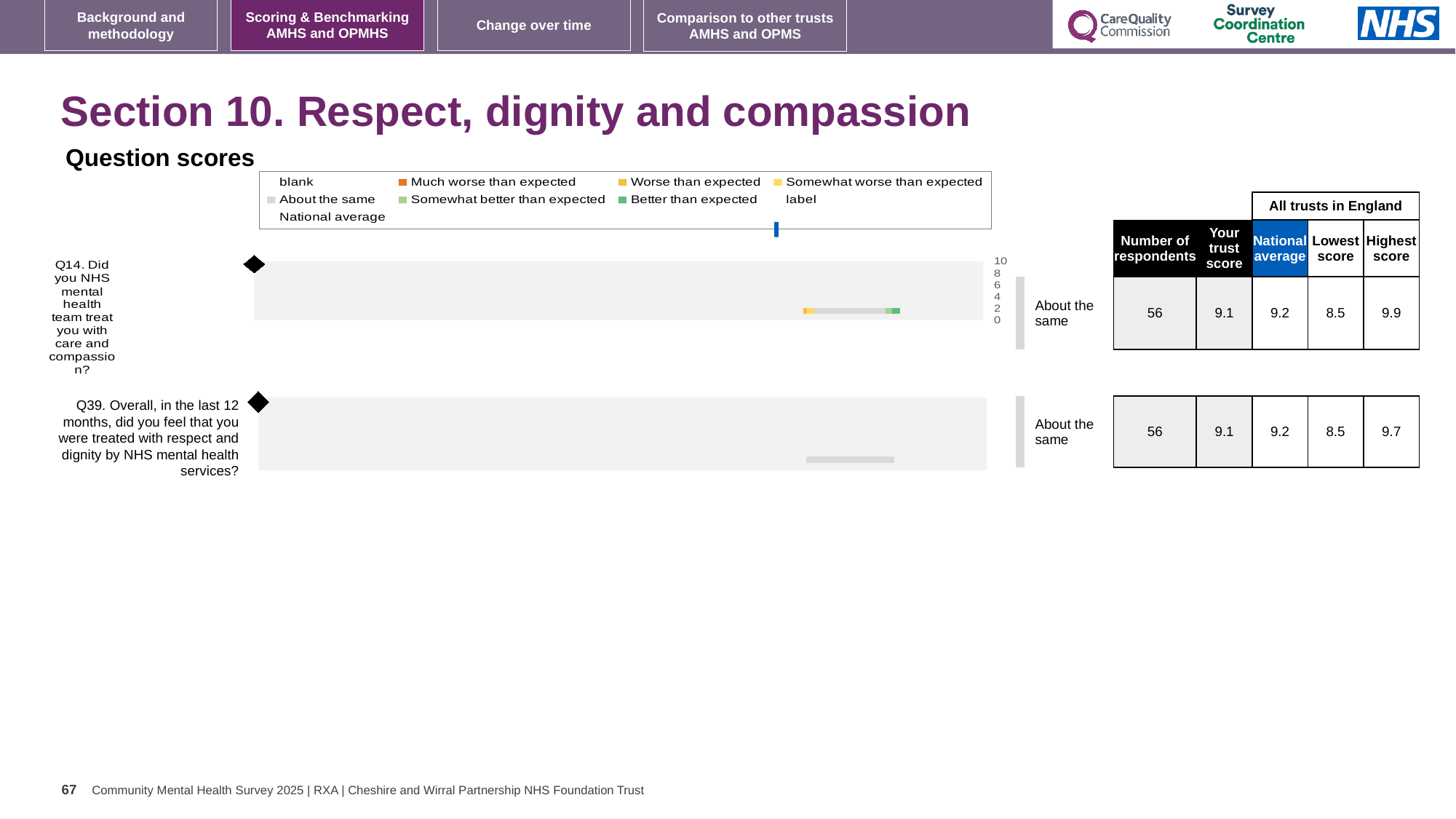
What is the lowest score across all trusts in England for Q14? 8.5 What kind of chart is used to show the question scores on this slide? bar chart What is the trust's score for Q14 (care and compassion) shown next to the chart? 9.1 What benchmark category is shown for Q14 in the chart? About the same How many respondents answered Q39? 56 What is the national average for Q39 (respect and dignity) shown next to the chart? 9.2 In the chart legend, what colour represents 'Much worse than expected'? orange Which question has the higher highest score across all trusts, Q14 or Q39? Q14 What is the highest score across all trusts in England for Q14? 9.9 What is the difference between the highest score for Q14 and the highest score for Q39? 0.2 What is the highest score across all trusts in England for Q39? 9.7 How many questions are plotted in the question scores chart? 2